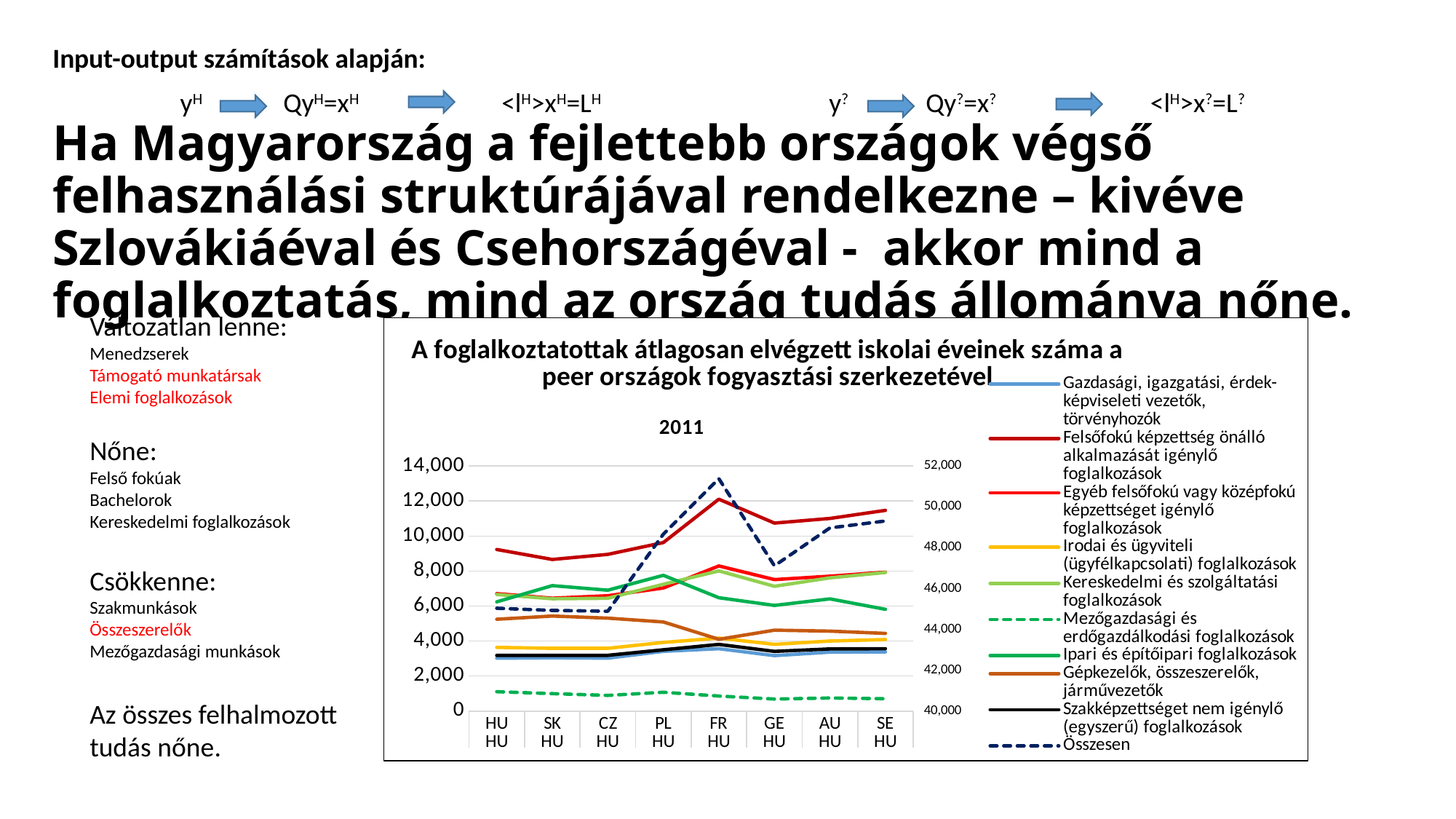
For which category does the 'Gépkezelők, összeszerelők, járművezetők' series have its lowest value? FR HU At FR HU, which is larger: 'Felsőfokú képzettség önálló alkalmazását igénylő foglalkozások' or 'Egyéb felsőfokú vagy középfokú képzettséget igénylő foglalkozások'? Felsőfokú képzettség önálló alkalmazását igénylő foglalkozások For which category does the 'Felsőfokú képzettség önálló alkalmazását igénylő foglalkozások' series reach its highest value? FR HU How many series does the chart's legend list? 10 Which series is drawn as a dashed dark blue line? Összesen For which category does the 'Összesen' series reach its highest value? FR HU Is the value of 'Felsőfokú képzettség önálló alkalmazását igénylő foglalkozások' at FR HU greater or less than 10,000? greater What kind of chart is shown on the slide? line chart What year is shown as the chart's subtitle? 2011 How many categories are shown on the x axis of the chart? 8 Is the value of 'Felsőfokú képzettség önálló alkalmazását igénylő foglalkozások' at HU HU greater or less than 10,000? less Is the value of 'Mezőgazdasági és erdőgazdálkodási foglalkozások' at HU HU greater or less than 2,000? less